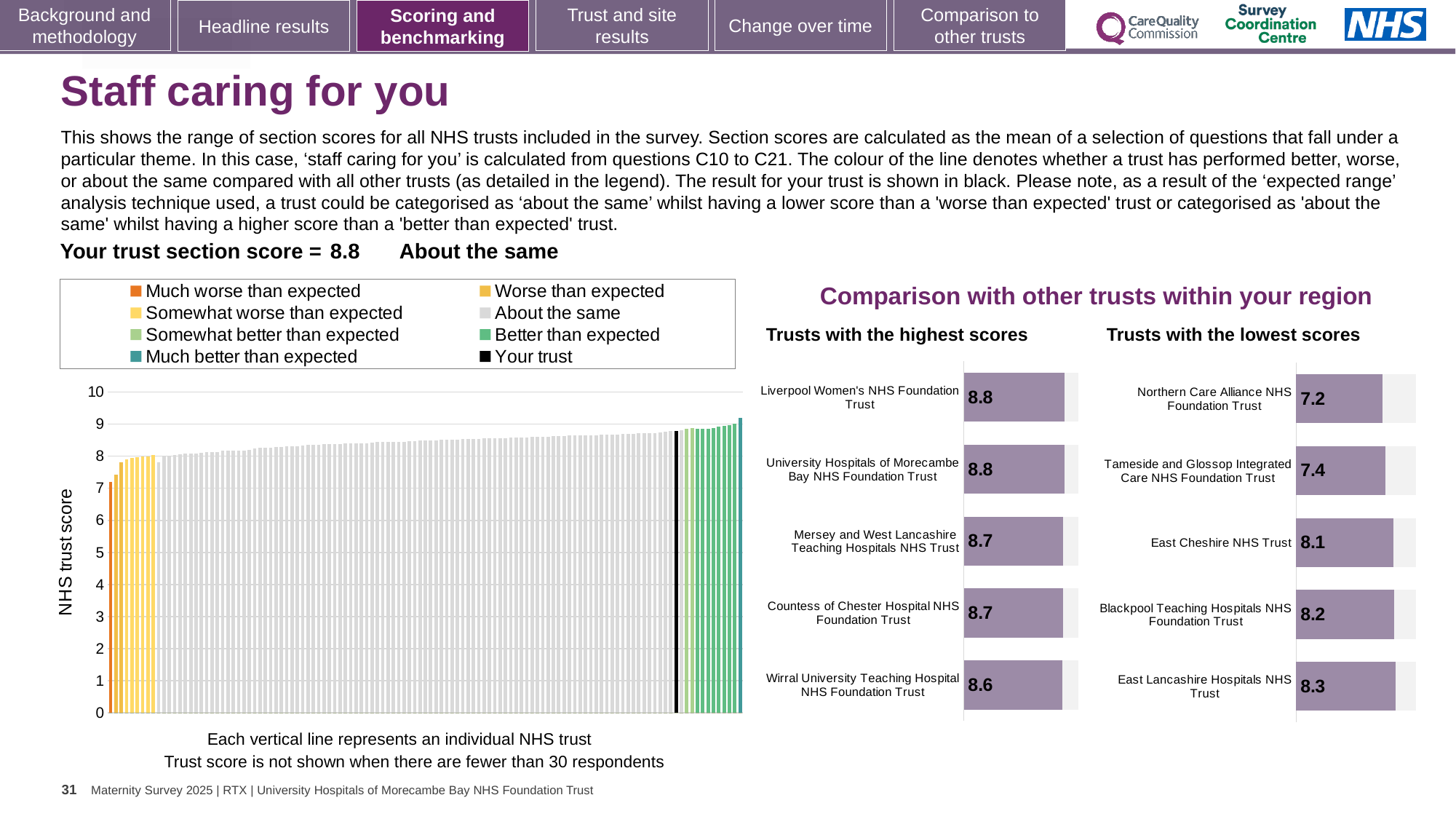
In the 'Trusts with the lowest scores' chart, what is the difference between the scores of East Lancashire Hospitals NHS Trust and Northern Care Alliance NHS Foundation Trust? 1.1 How many entries does the legend above the large chart on the left list? 8 In the 'Trusts with the highest scores' chart, what is the score for Wirral University Teaching Hospital NHS Foundation Trust? 8.6 In the 'Trusts with the lowest scores' chart, what is the score for Northern Care Alliance NHS Foundation Trust? 7.2 In the 'Trusts with the lowest scores' chart, what is the score for East Cheshire NHS Trust? 8.1 In the large chart on the left, do the NHS trust scores rise or fall from left to right? Rise What kind of chart is the large chart on the left showing NHS trust scores? Bar chart How many trusts are shown in the 'Trusts with the highest scores' chart? 5 In the 'Trusts with the lowest scores' chart, which has the larger score: Tameside and Glossop Integrated Care NHS Foundation Trust or Blackpool Teaching Hospitals NHS Foundation Trust? Blackpool Teaching Hospitals NHS Foundation Trust In the 'Trusts with the highest scores' chart, what is the score for Liverpool Women's NHS Foundation Trust? 8.8 In the 'Trusts with the lowest scores' chart, which trust has the lowest score? Northern Care Alliance NHS Foundation Trust In the 'Trusts with the lowest scores' chart, which trust has the highest score? East Lancashire Hospitals NHS Trust